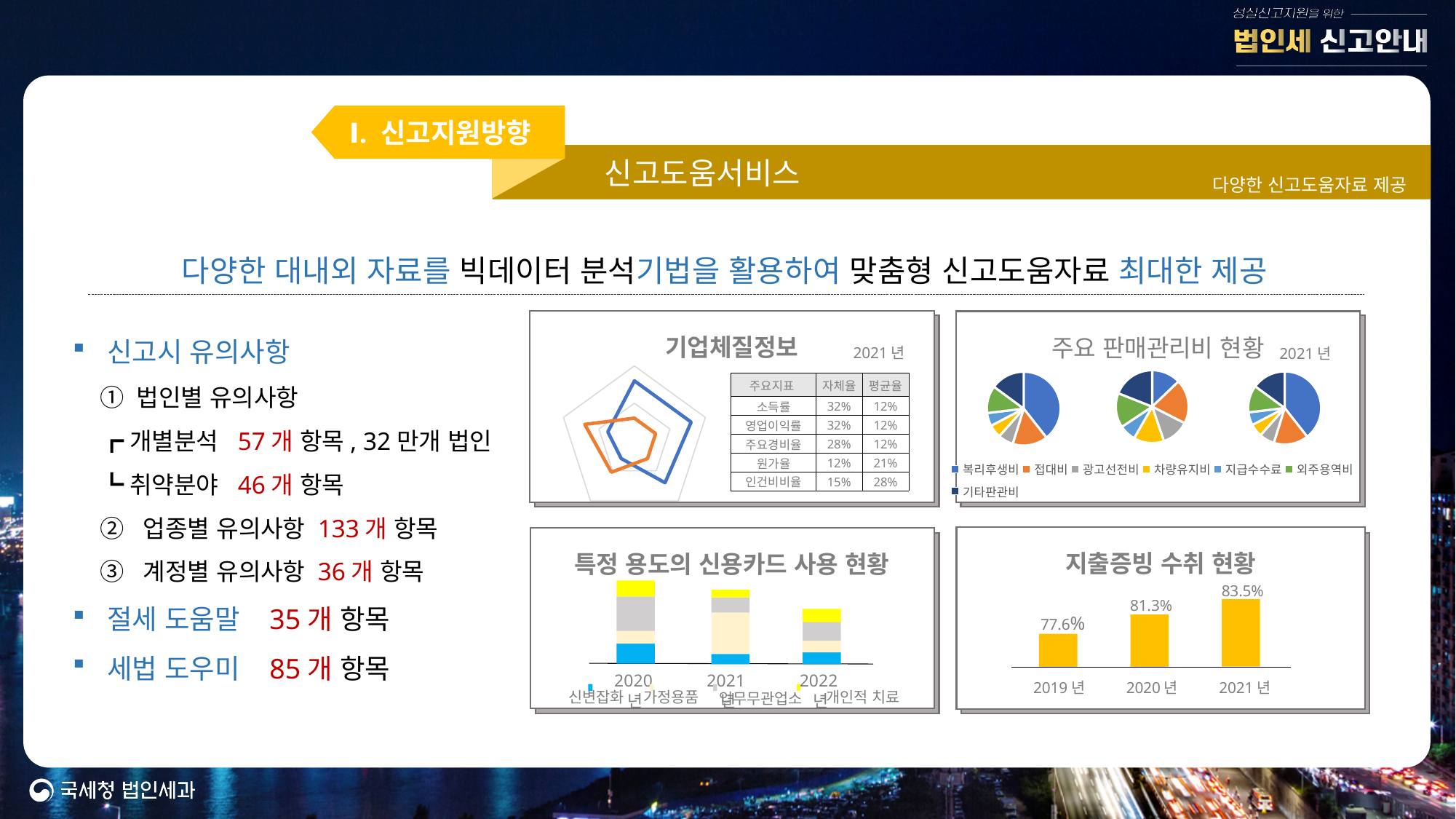
In the 지출증빙 수취 현황 chart, what is the value for 2019 년? 77.6% In the 지출증빙 수취 현황 chart, what is the difference between the 2021 년 and 2019 년 values? 5.9% In the 특정 용도의 신용카드 사용 현황 chart, which year has the tallest stacked bar? 2020 년 In the 지출증빙 수취 현황 chart, what is the value for 2021 년? 83.5% In the 지출증빙 수취 현황 chart, which year has the lowest value? 2019 년 How many pie charts are shown in the 주요 판매관리비 현황 panel? 3 What kind of chart is the 지출증빙 수취 현황 chart? bar chart How many years are shown on the x axis of the 특정 용도의 신용카드 사용 현황 chart? 3 What kind of chart is shown in the 기업체질정보 panel? radar chart In the 지출증빙 수취 현황 chart, do the values rise or fall from 2019 년 to 2021 년? rise How many series does the legend of the 주요 판매관리비 현황 chart list? 7 In the 지출증빙 수취 현황 chart, which year has the highest value? 2021 년